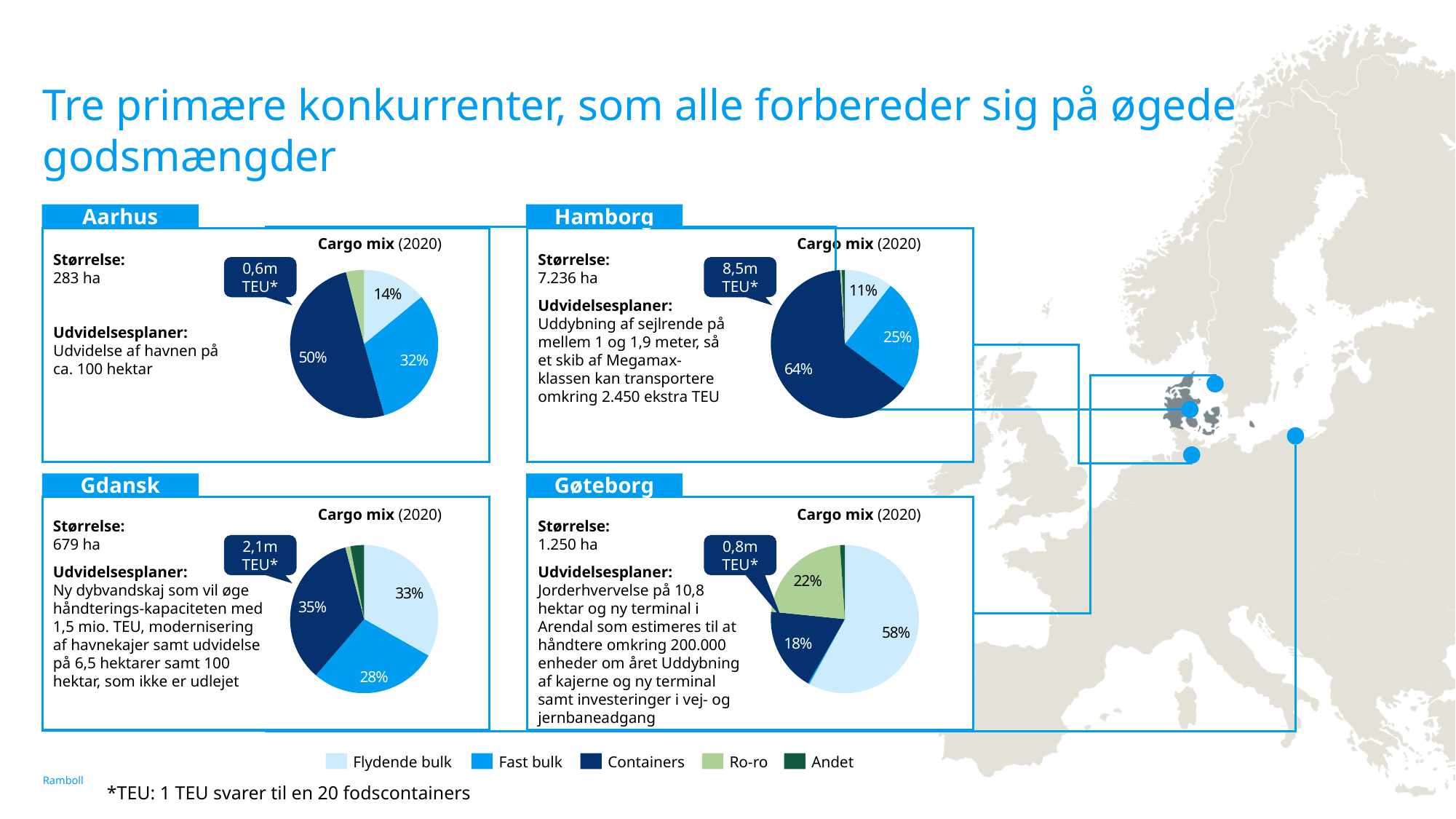
In the Aarhus Cargo mix (2020) pie chart, what is the difference between the Containers share and the Fast bulk share? 18% In the Aarhus Cargo mix (2020) pie chart, what share is labelled for Containers (dark navy slice)? 50% How many Cargo mix (2020) pie charts are shown on the slide? 4 How many cargo categories does the shared legend at the bottom of the slide list? 5 In the Göteborg Cargo mix (2020) pie chart, what share is labelled for Ro-ro (light green slice)? 22% In the Hamborg Cargo mix (2020) pie chart, what share is labelled for Fast bulk (medium blue slice)? 25% In the Hamborg Cargo mix (2020) pie chart, what is the difference between the Containers share and the Flydende bulk share? 53% In the Gdansk Cargo mix (2020) pie chart, what share is labelled for Flydende bulk (light blue slice)? 33% In the Hamborg Cargo mix (2020) pie chart, which cargo category has the largest share? Containers In the Göteborg Cargo mix (2020) pie chart, which cargo category has the largest share? Flydende bulk What type of chart is used to show the Cargo mix (2020) for each port? Pie chart In the Gdansk Cargo mix (2020) pie chart, which is larger: the Containers share or the Fast bulk share? Containers